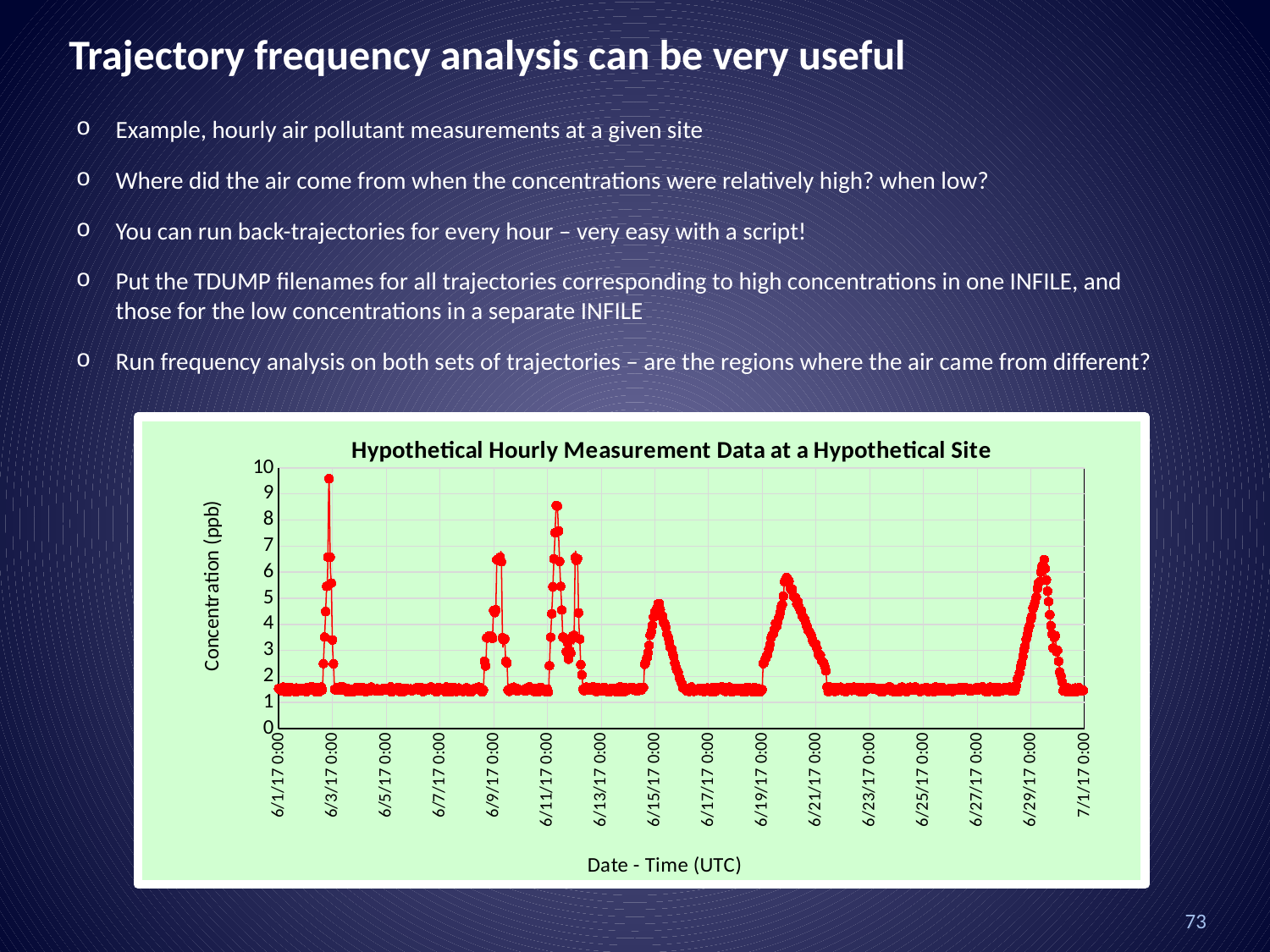
Which peak is higher: the one near 6/3/17 or the one near 6/15/17? 6/3/17 Is the baseline concentration between the peaks greater or less than 2? less Is the peak in concentration near 6/11/17 greater or less than 8? greater What is the label of the vertical axis of the chart? Concentration (ppb) What is the maximum value shown on the vertical axis? 10 Is the highest peak in concentration (near 6/3/17) greater or less than 9? greater How many date tick labels are shown along the x axis? 16 What is the title of the chart? Hypothetical Hourly Measurement Data at a Hypothetical Site Around which x-axis date does the highest peak in concentration occur? 6/3/17 0:00 What kind of chart is shown on the slide? Line chart